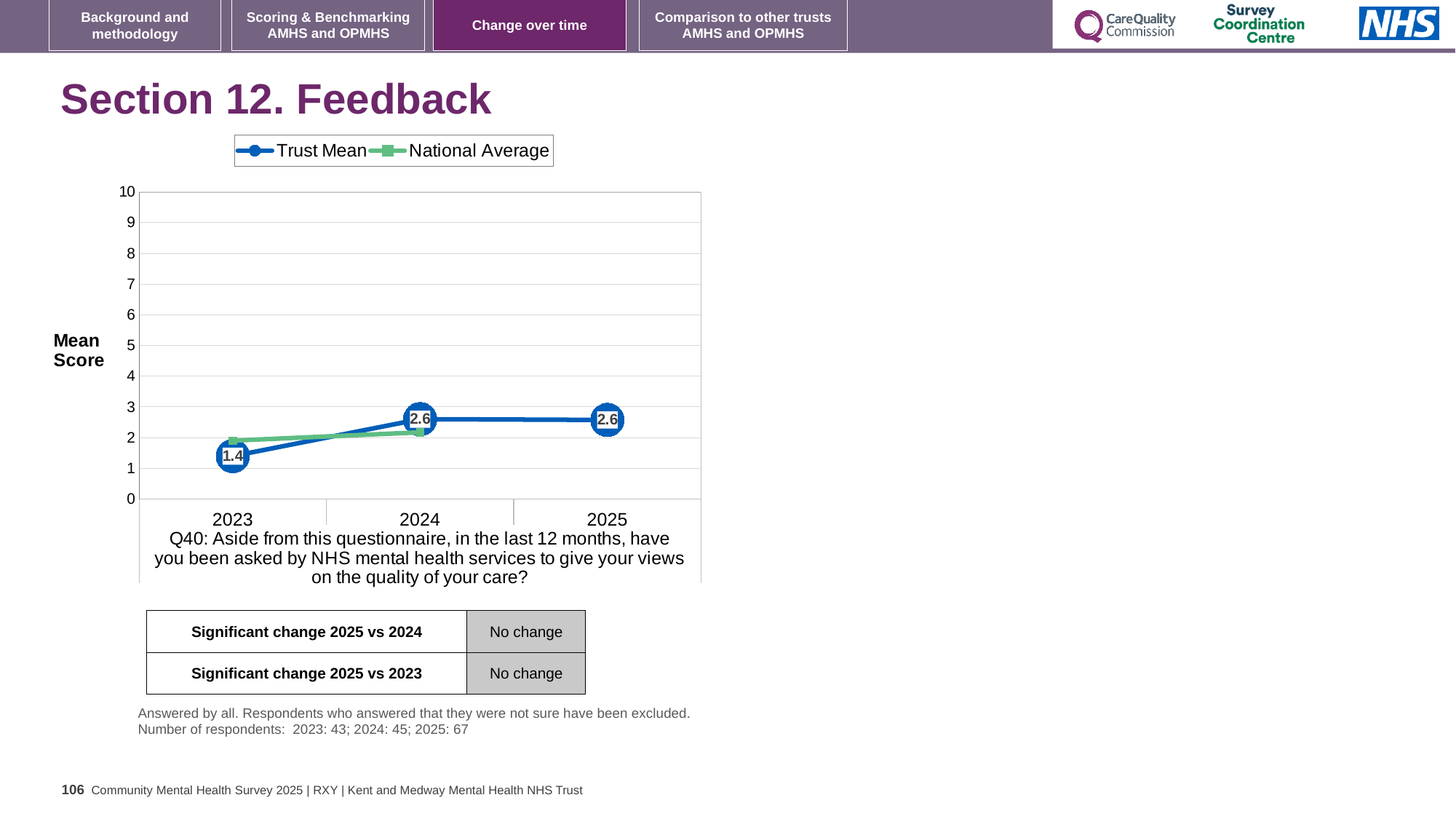
How many series does the legend list? 2 Is the Trust Mean value for 2025 greater or less than 5? less In which year is the Trust Mean lowest? 2023 What kind of chart is shown on the slide? line chart How many years are plotted on the x axis? 3 Which is larger, the Trust Mean for 2023 or for 2025? 2025 Does the Trust Mean rise or fall from 2023 to 2024? rise What is the Trust Mean value for 2024? 2.6 What is the Trust Mean value for 2023? 1.4 What is the difference between the Trust Mean in 2024 and in 2023? 1.2 What is the label on the y axis of the chart? Mean Score What is the Trust Mean value for 2025? 2.6